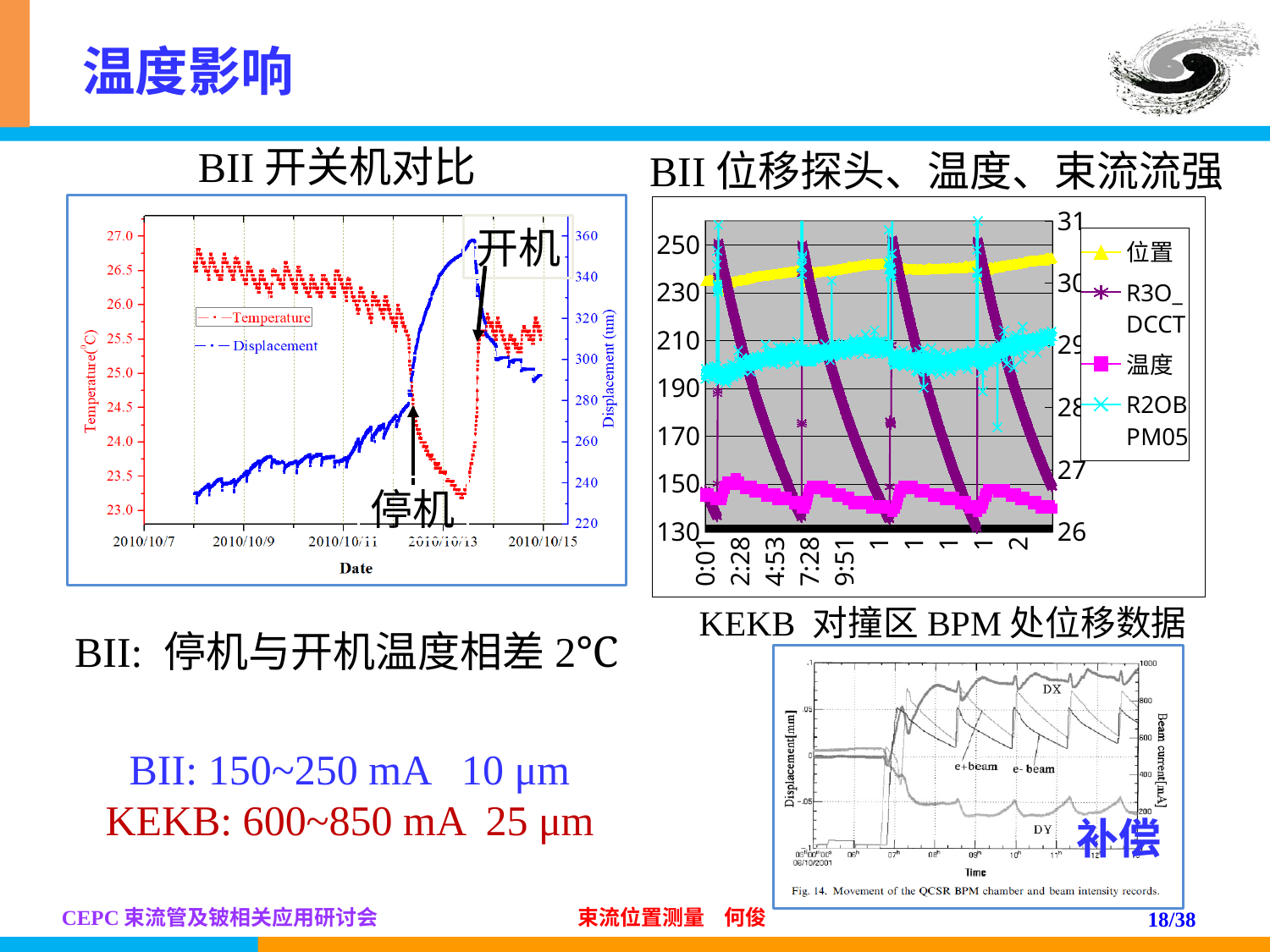
In the chart titled 'BII 开关机对比', does the Temperature series rise or fall from 2010/10/7 to 2010/10/13? fall In the chart titled 'BII 开关机对比', does the Displacement series rise or fall from 2010/10/8 to 2010/10/13? rise What kind of chart is the KEKB chart at the bottom right of the slide? line chart In the chart titled 'BII 开关机对比', is the lowest Temperature value reached near 2010/10/13 greater or less than 24.0? less In the chart titled 'BII 位移探头、温度、束流流强', what is the highest tick on the right-hand axis? 31 What kind of chart is the one titled 'BII 开关机对比'? line chart In the chart titled 'BII 位移探头、温度、束流流强', how many series does the legend list? 4 In the chart titled 'BII 开关机对比', what are the two series named in the legend? Temperature and Displacement In the chart titled 'BII 开关机对比', how many series does the legend list? 2 In the chart titled 'BII 开关机对比', is the Temperature value at 2010/10/8 greater or less than 26.0? greater